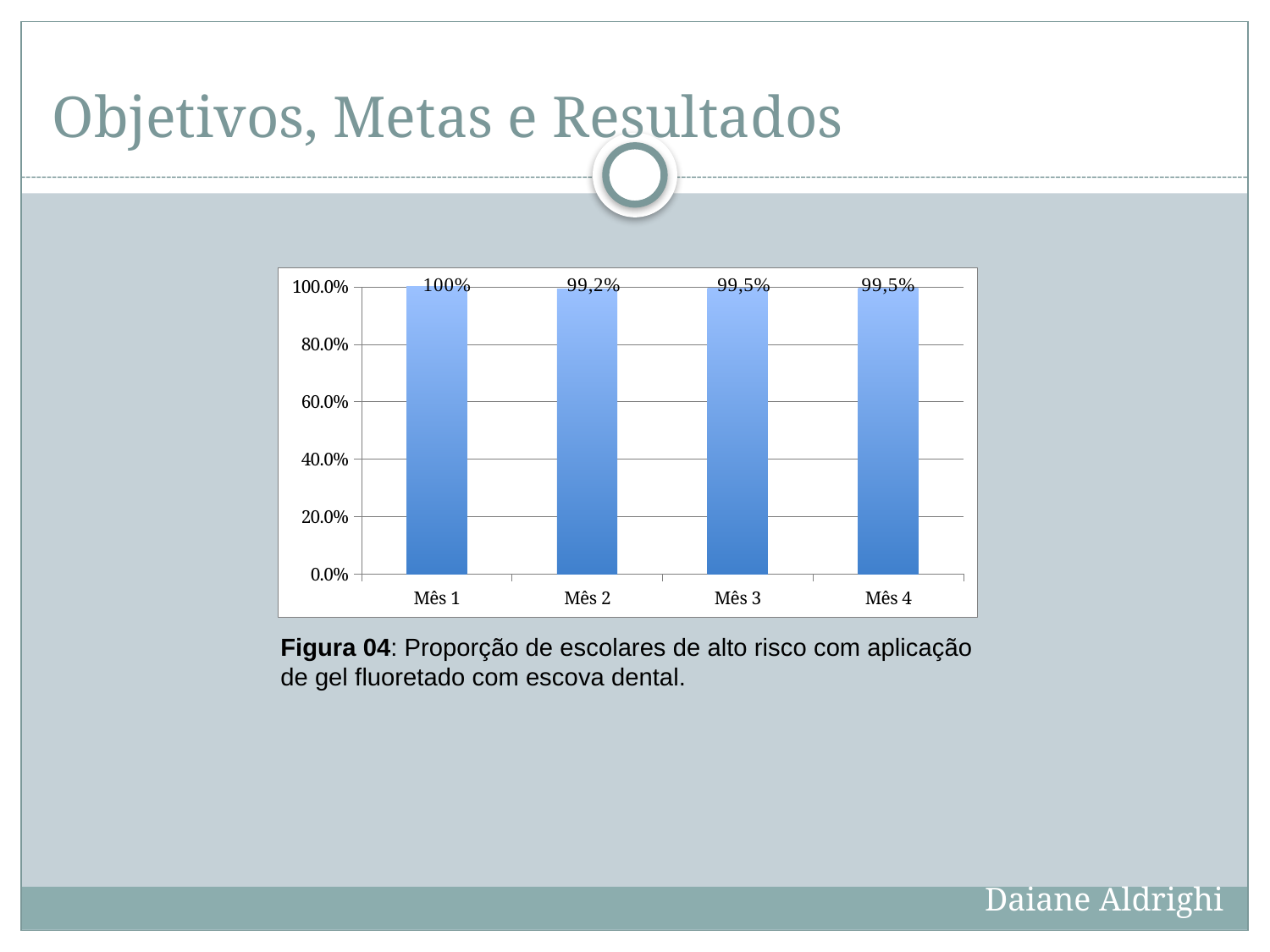
What is the value for Mês 1? 100% What is the value for Mês 3? 99,5% What kind of chart is shown on the slide? bar chart Which month has the highest value? Mês 1 Is the value for Mês 3 greater or less than 80.0%? greater How many months are shown on the x axis? 4 Which is larger, the value for Mês 1 or the value for Mês 2? Mês 1 What is the value for Mês 2? 99,2% What figure number is given in the caption below the chart? Figura 04 Which month has the lowest value? Mês 2 What is the difference between the values for Mês 1 and Mês 2? 0,8% What is the value for Mês 4? 99,5%